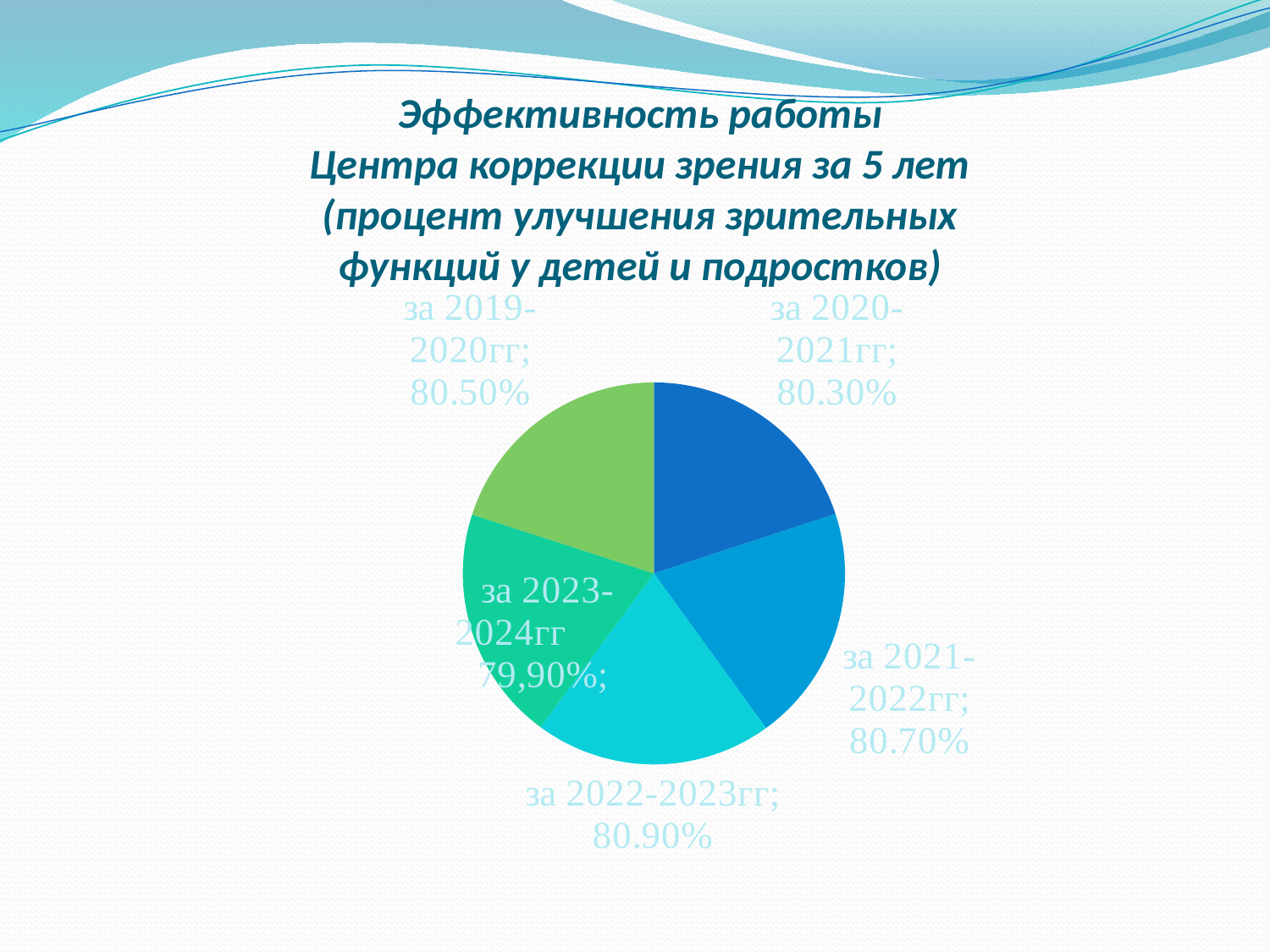
What is the value shown for за 2022-2023гг? 80.90% How many slices does the pie chart have? 5 Which period has the lowest value in the pie chart? за 2023-2024гг Which is larger, the value for за 2021-2022гг or the value for за 2019-2020гг? за 2021-2022гг What is the value shown for за 2019-2020гг? 80.50% What is the value shown for за 2023-2024гг? 79,90% What colour is the slice for за 2020-2021гг? dark blue What is the difference between the values for за 2022-2023гг and за 2020-2021гг? 0.60% What kind of chart is shown on the slide? pie chart What is the value shown for за 2020-2021гг? 80.30% What is the value shown for за 2021-2022гг? 80.70% Which period has the highest value in the pie chart? за 2022-2023гг